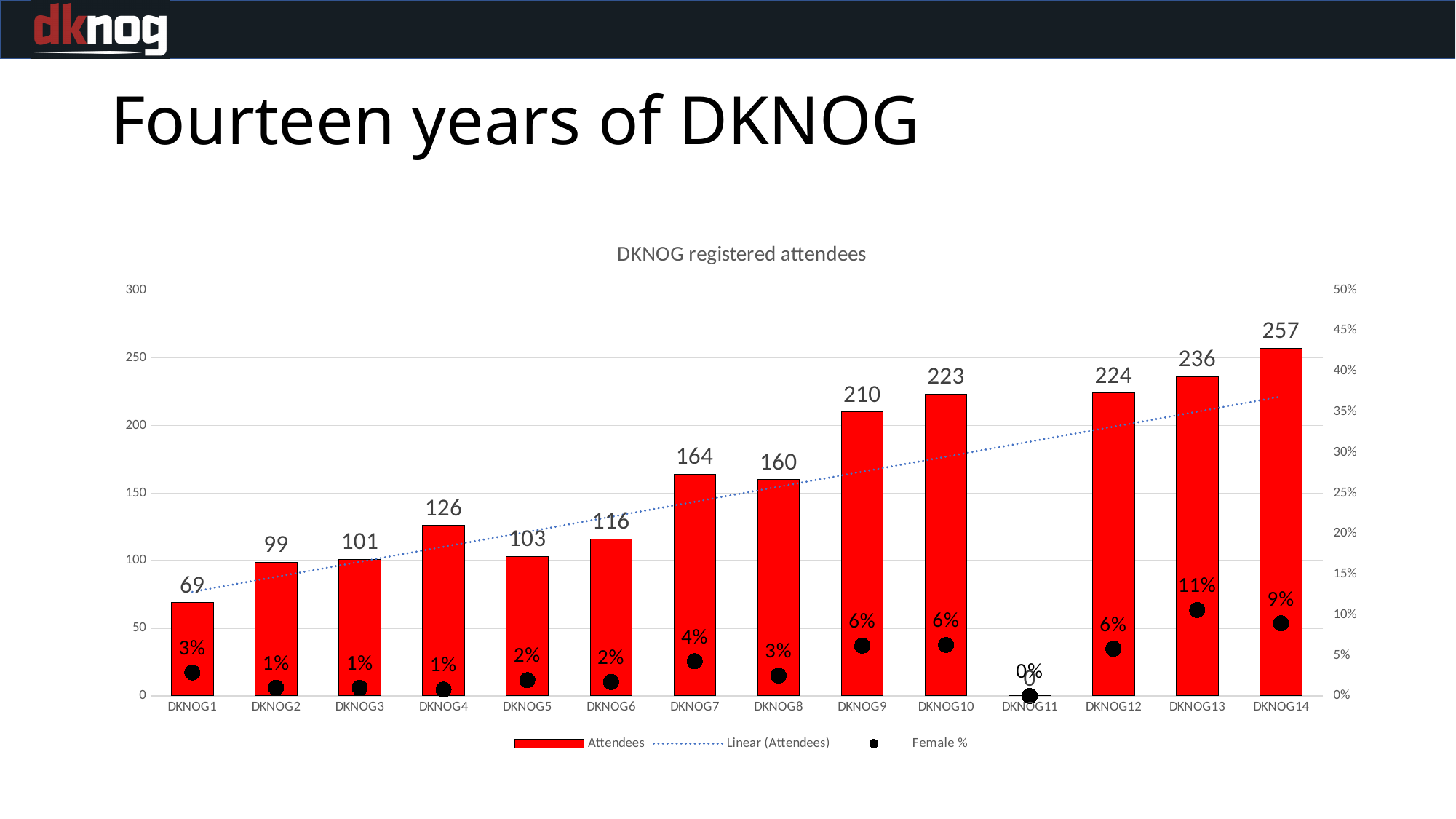
What kind of chart is used to show the attendees? bar chart How many DKNOG events are shown on the x axis? 14 What is the title of the chart? DKNOG registered attendees What is the difference in attendees between DKNOG14 and DKNOG13? 21 Is the number of attendees for DKNOG9 greater or less than 200? greater What is the Female % value for DKNOG13? 11% What is the number of attendees for DKNOG14? 257 Which DKNOG event has the highest number of attendees? DKNOG14 What is the Female % value for DKNOG1? 3% How many entries does the legend list? 3 Which has more attendees, DKNOG7 or DKNOG8? DKNOG7 Which DKNOG event has the lowest number of attendees? DKNOG11